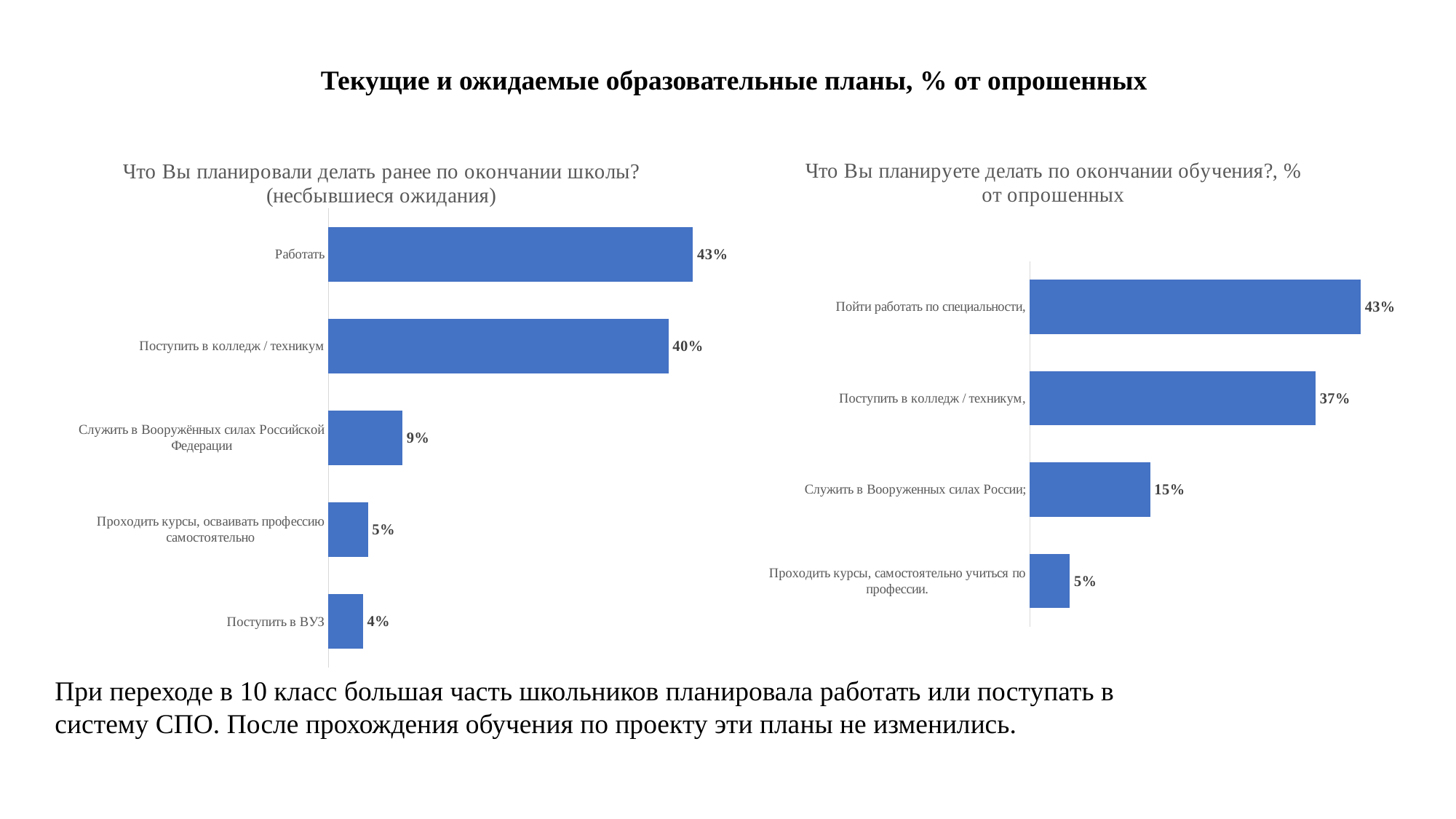
How many categories are shown in the right chart ("Что Вы планируете делать по окончании обучения?")? 4 In the left chart ("Что Вы планировали делать ранее по окончании школы?"), which is larger: "Служить в Вооружённых силах Российской Федерации" or "Проходить курсы, осваивать профессию самостоятельно"? Служить в Вооружённых силах Российской Федерации In the left chart ("Что Вы планировали делать ранее по окончании школы?"), which category has the lowest value? Поступить в ВУЗ In the right chart ("Что Вы планируете делать по окончании обучения?"), which category has the highest value? Пойти работать по специальности How many categories are shown in the left chart ("Что Вы планировали делать ранее по окончании школы?")? 5 What type of chart is the right chart ("Что Вы планируете делать по окончании обучения?")? Bar chart In the right chart ("Что Вы планируете делать по окончании обучения?"), what is the value for "Поступить в колледж / техникум"? 37% In the left chart ("Что Вы планировали делать ранее по окончании школы?"), what is the value for "Поступить в ВУЗ"? 4% In the right chart ("Что Вы планируете делать по окончании обучения?"), what is the value for "Служить в Вооруженных силах России"? 15% In the left chart ("Что Вы планировали делать ранее по окончании школы?"), what is the difference between "Работать" and "Поступить в колледж / техникум"? 3% In the right chart ("Что Вы планируете делать по окончании обучения?"), what is the difference between "Пойти работать по специальности" and "Проходить курсы, самостоятельно учиться по профессии"? 38% In the left chart ("Что Вы планировали делать ранее по окончании школы?"), what is the value for "Работать"? 43%